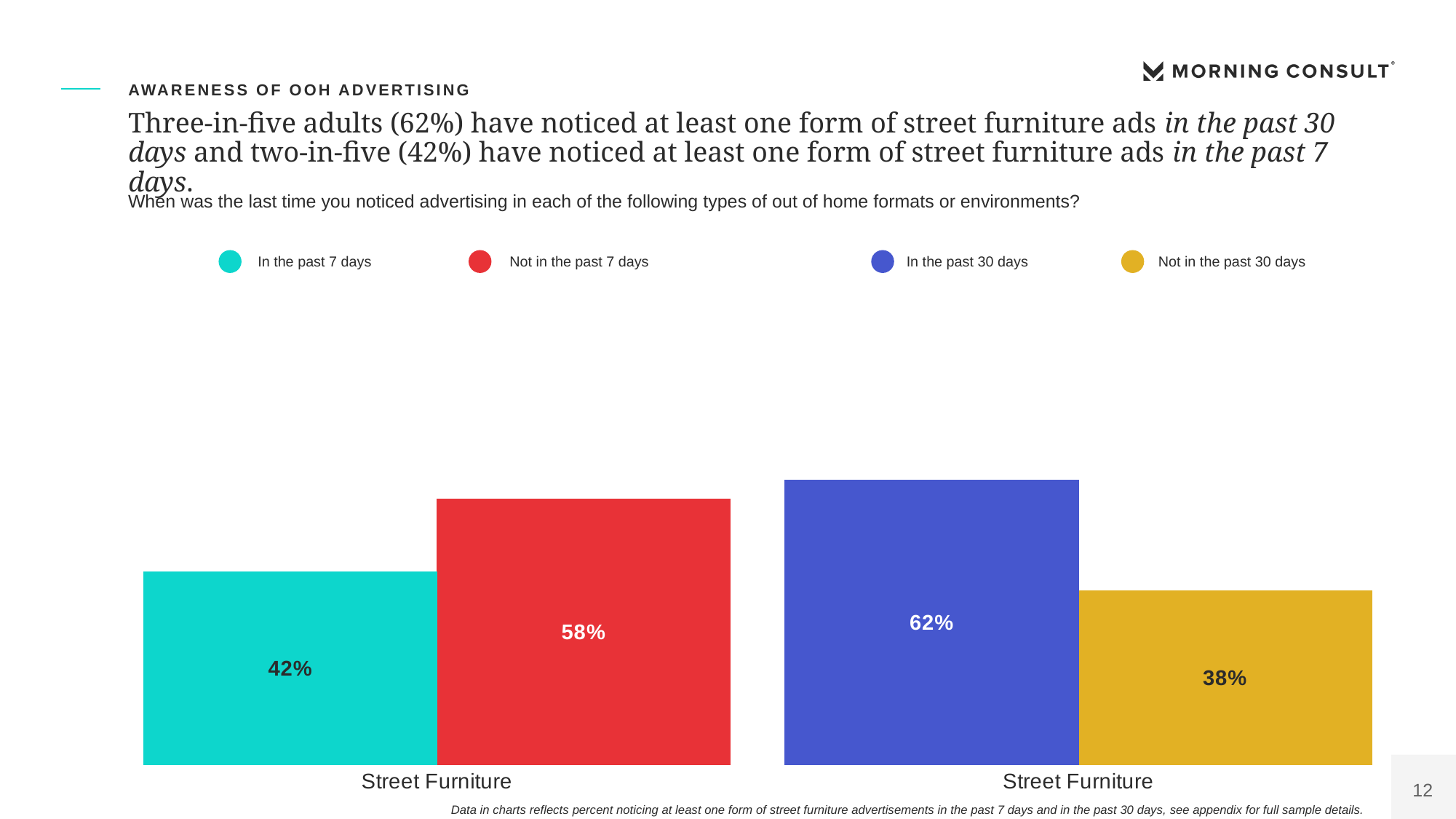
In the left chart, which series has the lower value? In the past 7 days In the left chart, what is the value for 'Not in the past 7 days'? 58% In the left chart, what is the difference between 'Not in the past 7 days' and 'In the past 7 days'? 16% In the right chart, what is the difference between 'In the past 30 days' and 'Not in the past 30 days'? 24% What colour represents 'Not in the past 30 days' in the legend? Yellow What type of chart is used on this slide? Bar chart How many series does the legend list across the charts? 4 In the right chart, what is the value for 'Not in the past 30 days'? 38% Which is larger: 'In the past 7 days' in the left chart or 'In the past 30 days' in the right chart? In the past 30 days In the left chart, what percentage noticed street furniture ads in the past 7 days? 42% In the right chart, what percentage noticed street furniture ads in the past 30 days? 62% In the right chart, which series has the higher value? In the past 30 days